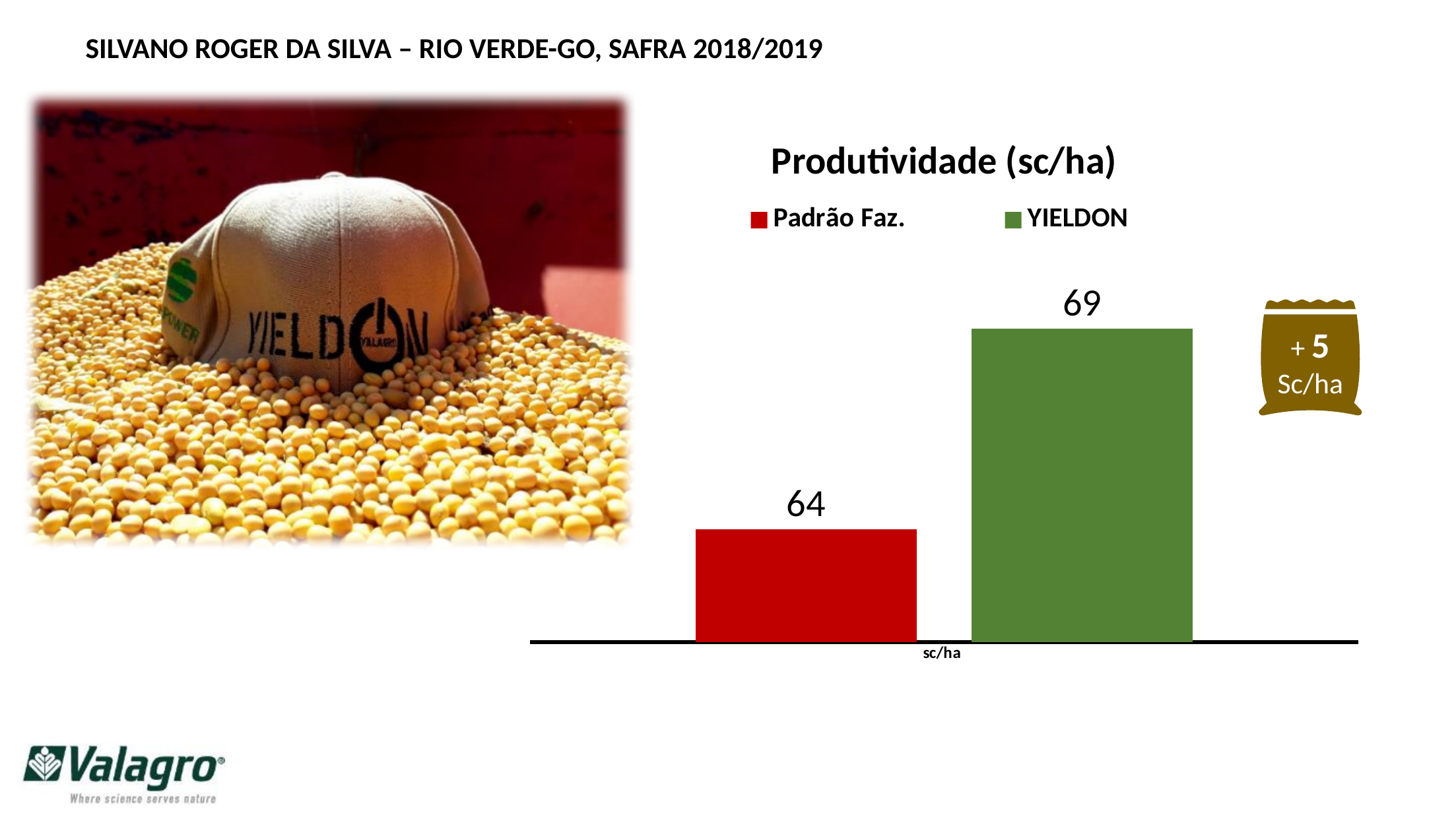
How many series does the legend of the Produtividade (sc/ha) chart list? 2 What is the value for YIELDON in the Produtividade (sc/ha) chart? 69 What colour is the YIELDON bar in the Produtividade (sc/ha) chart? green What is the value for Padrão Faz. in the Produtividade (sc/ha) chart? 64 Which is larger in the Produtividade (sc/ha) chart, Padrão Faz. or YIELDON? YIELDON What is the difference between the YIELDON and Padrão Faz. values in the Produtividade (sc/ha) chart? 5 What is the title of the chart on the slide? Produtividade (sc/ha) How many bars are plotted in the Produtividade (sc/ha) chart? 2 What is the x-axis category label in the Produtividade (sc/ha) chart? sc/ha Which series has the lowest value in the Produtividade (sc/ha) chart? Padrão Faz. Which series has the highest value in the Produtividade (sc/ha) chart? YIELDON What kind of chart is the Produtividade (sc/ha) chart? bar chart